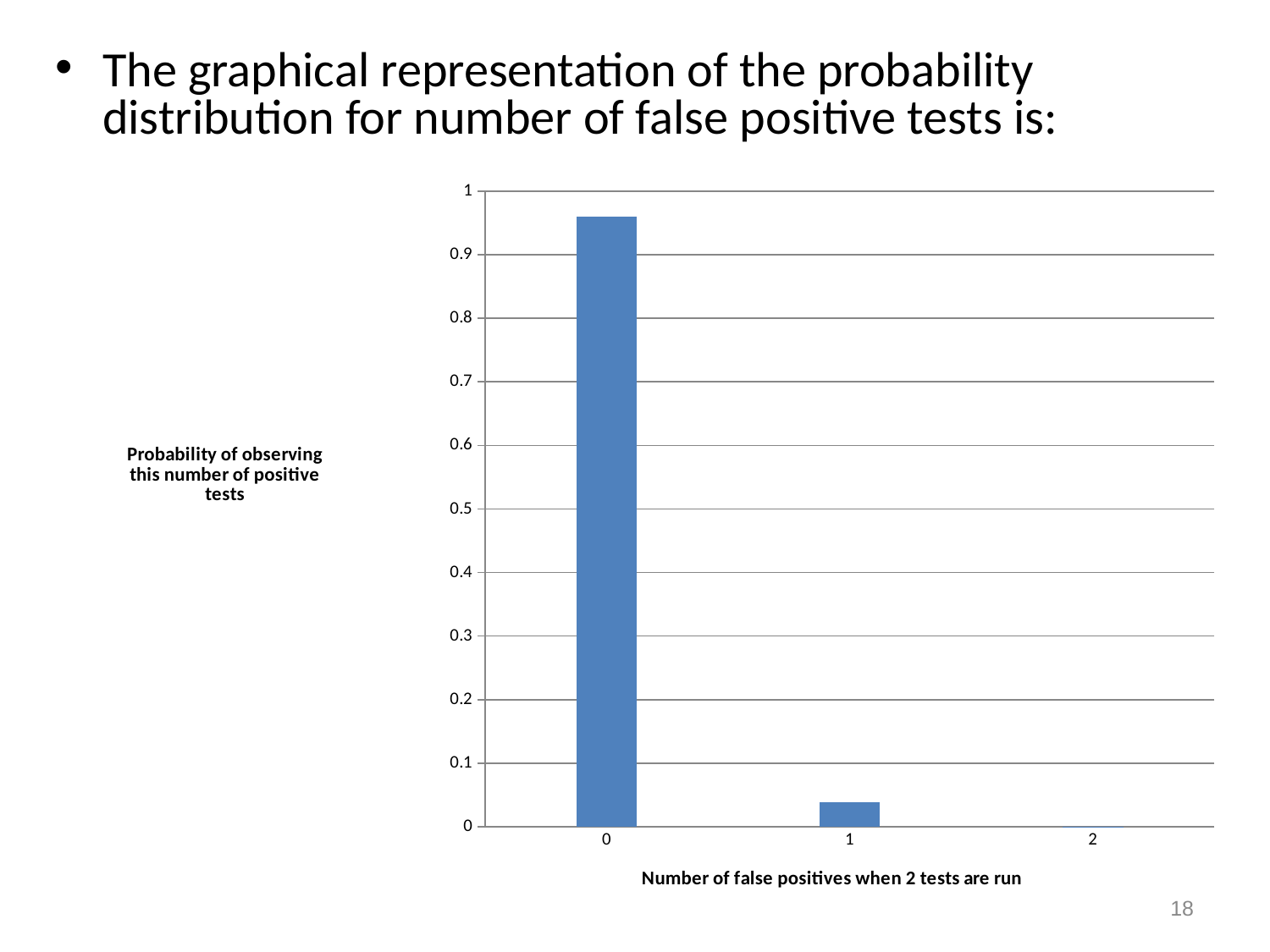
How many categories are shown on the x axis of the chart? 3 Is the probability for 1 false positive greater or less than 0.1? less What kind of chart is shown on the slide? bar chart Is the probability for 0 false positives greater or less than 0.5? greater Is the probability for 0 false positives greater or less than 0.9? greater What is the title of the y axis of the chart? Probability of observing this number of positive tests What is the highest value shown on the y axis of the chart? 1 Which number of false positives has the highest probability in the chart? 0 What is the title of the x axis of the chart? Number of false positives when 2 tests are run Which has the larger probability: 0 false positives or 1 false positive? 0 Do the probabilities rise or fall as the number of false positives increases along the x axis? fall